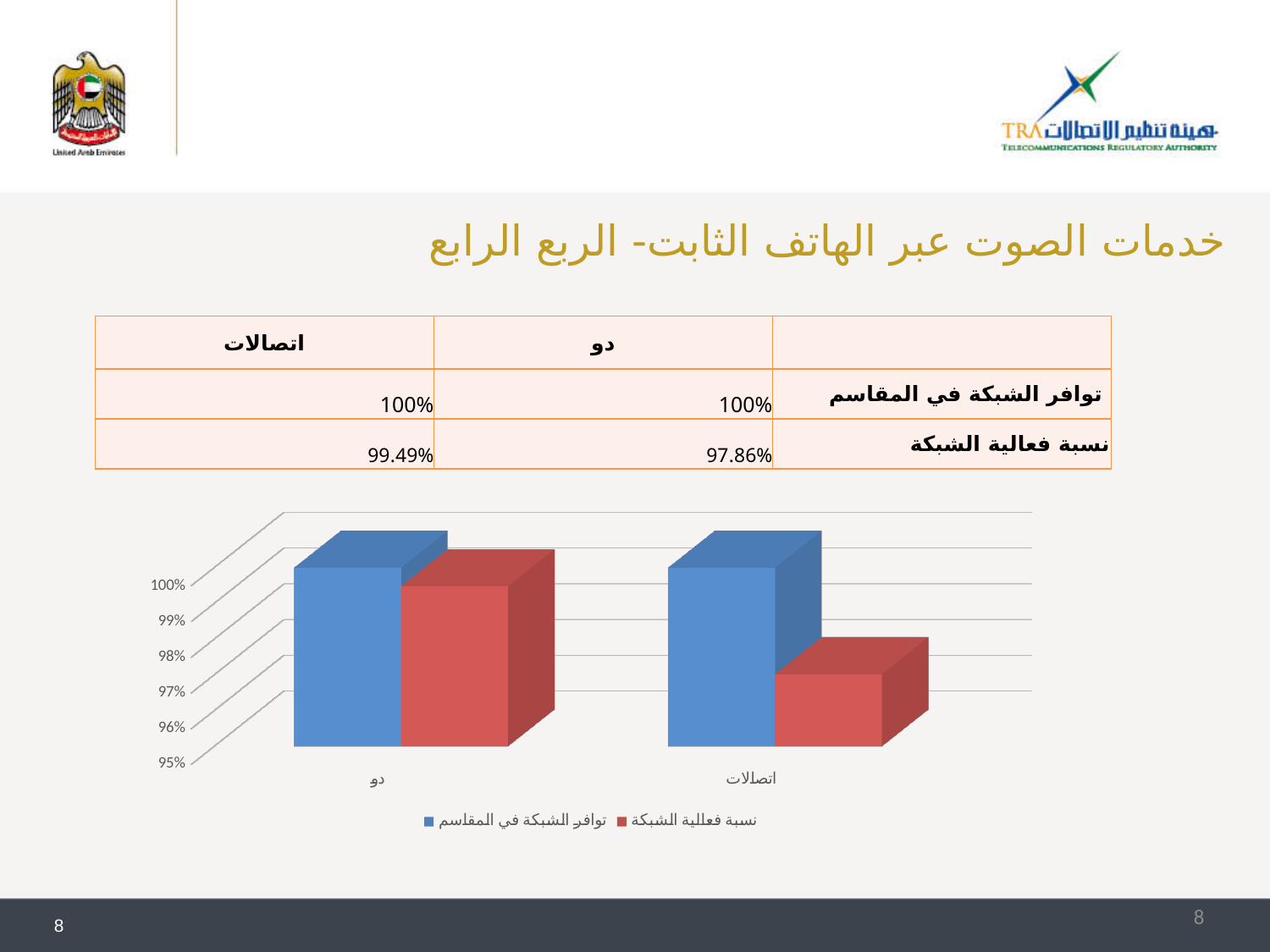
According to the table, what is the value of نسبة فعالية الشبكة for دو? 97.86% How many categories are shown on the x axis of the chart? 2 According to the table, what is the value of توافر الشبكة في المقاسم for دو? 100% In the chart, is the value of the red bar for اتصالات greater or less than 99%? less According to the table, what is the value of نسبة فعالية الشبكة for اتصالات? 99.49% According to the table, what is the difference between the نسبة فعالية الشبكة values of اتصالات and دو? 1.63% Which two categories appear on the x axis of the chart? دو and اتصالات What is the lowest value shown on the chart's vertical axis? 95% What kind of chart is shown on the slide? bar chart How many series does the chart legend list? 2 In the chart, is the value of the blue bar for دو greater or less than 98%? greater According to the table, which operator has the higher نسبة فعالية الشبكة, دو or اتصالات? اتصالات